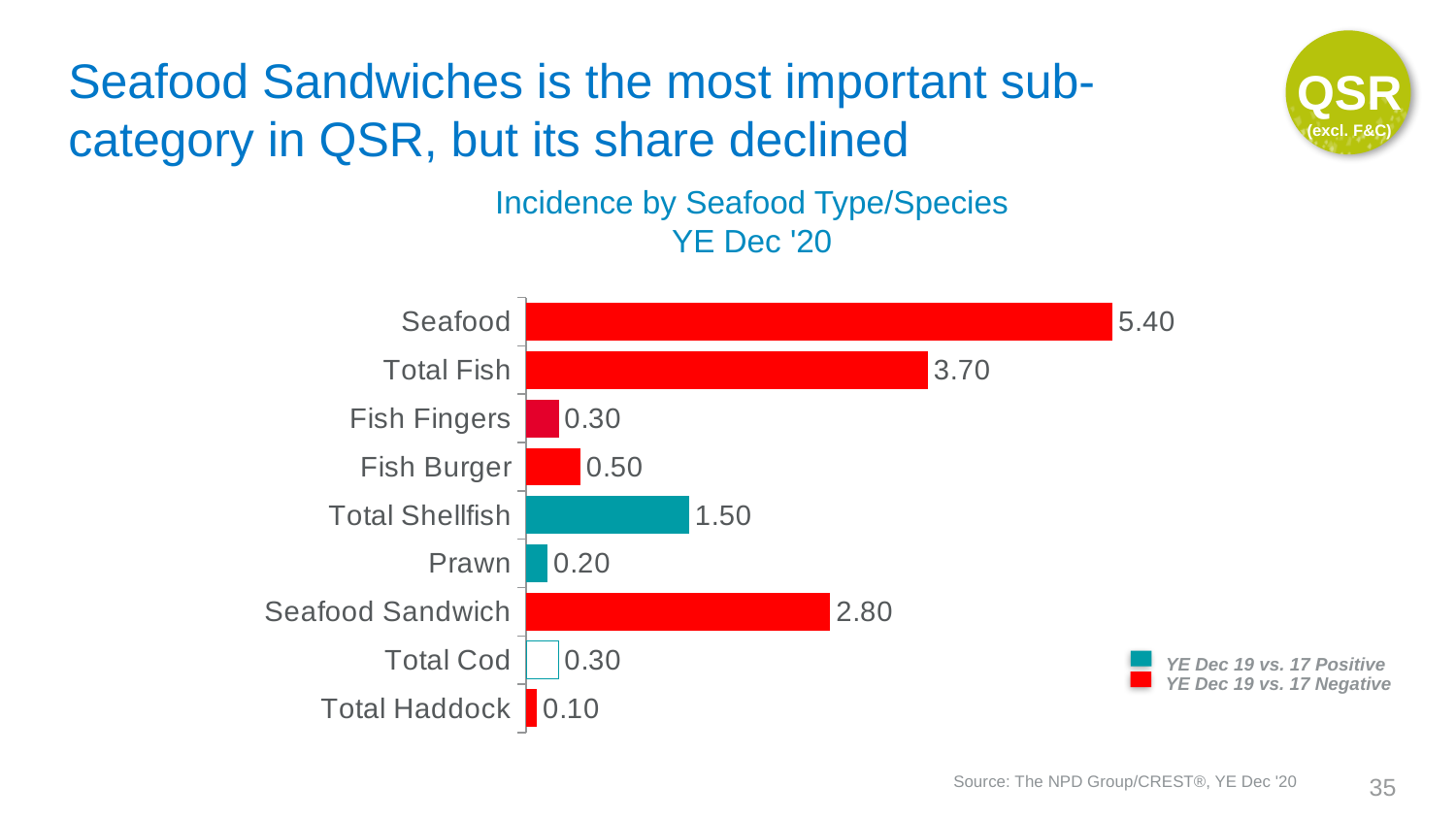
What is the title of the chart? Incidence by Seafood Type/Species YE Dec '20 What is the value for Total Shellfish? 1.50 What is the value for Total Haddock? 0.10 What kind of chart is shown on the slide? Bar chart Which is larger, the value for Fish Burger or the value for Prawn? Fish Burger According to the legend, what does a red bar indicate? YE Dec 19 vs. 17 Negative What is the difference between the values for Seafood and Total Fish? 1.70 What is the value for Seafood? 5.40 Which category has the lowest value? Total Haddock How many categories are shown in the chart? 9 Which category has the highest value? Seafood What is the value for Seafood Sandwich? 2.80